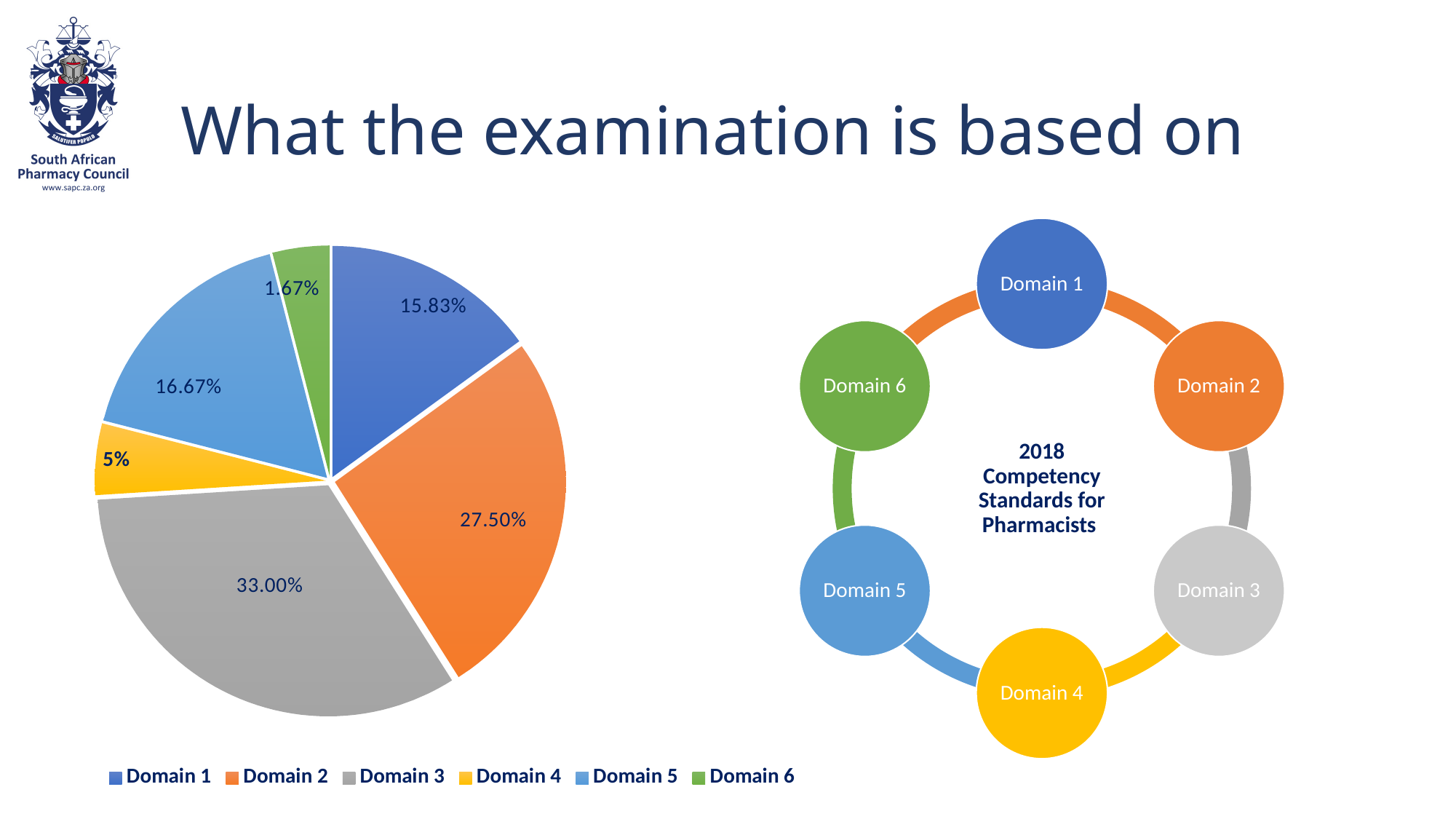
How many slices does the pie chart have? 6 What is the value shown for Domain 4? 5% What is the difference between the values for Domain 3 and Domain 2? 5.50% Which colour represents Domain 4 in the legend? Yellow What kind of chart is shown on the slide? Pie chart What is the value shown for Domain 5? 16.67% Which is larger, the value for Domain 5 or the value for Domain 1? Domain 5 What share of the pie does Domain 3 represent? 33.00% Which domain has the largest slice of the pie? Domain 3 Which domain has the smallest slice of the pie? Domain 6 What is the value shown for Domain 2? 27.50% What is the value shown for Domain 1? 15.83%